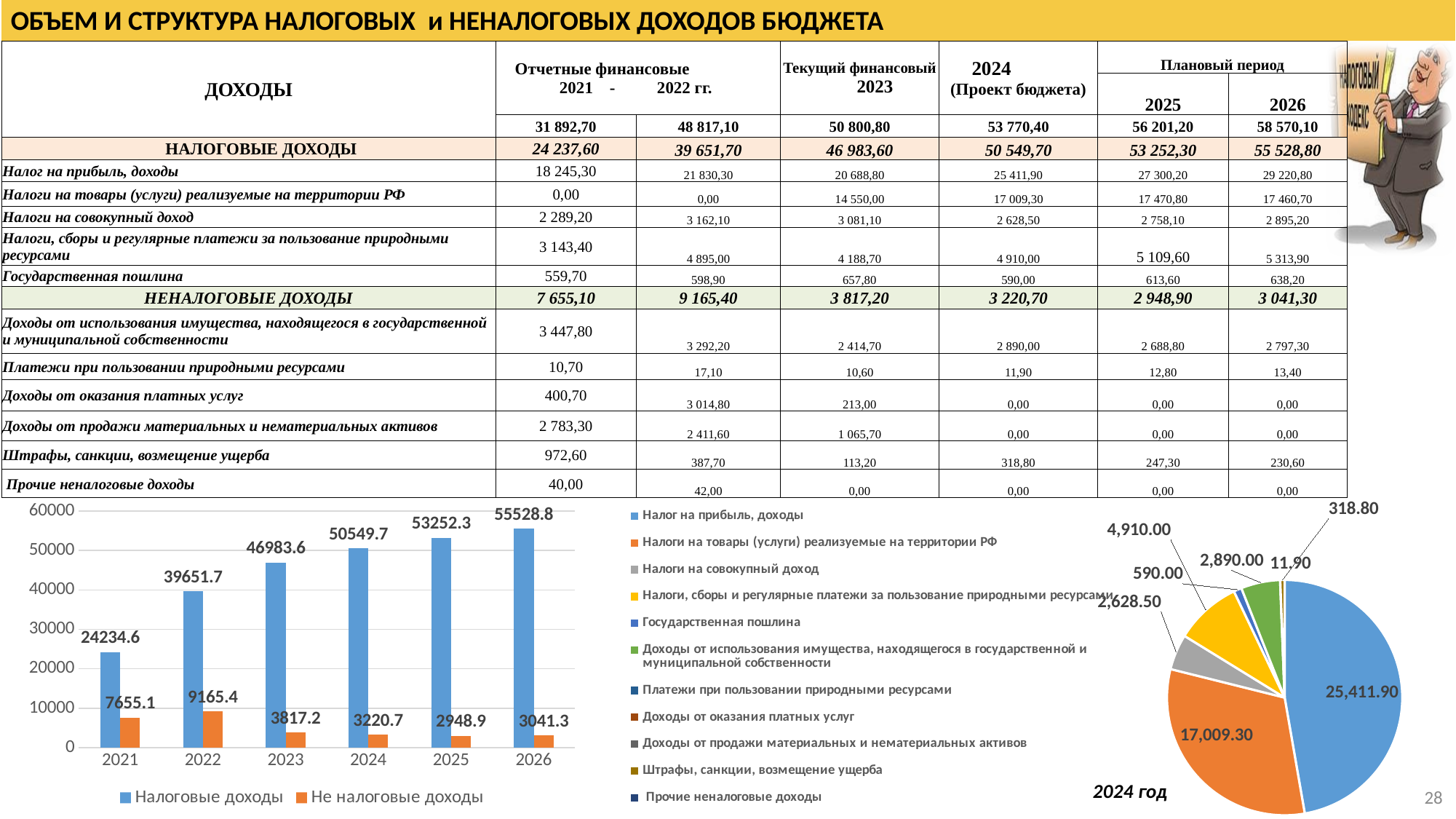
In the bar chart at the bottom left, what is the value of Не налоговые доходы for 2022? 9165.4 In the pie chart at the bottom right (2024 год), what is the value of the orange slice? 17,009.30 In the bar chart at the bottom left, which year has the lowest value of Не налоговые доходы? 2025 In the bar chart at the bottom left, what is the value of Налоговые доходы for 2024? 50549.7 In the pie chart at the bottom right (2024 год), what is the value of the largest slice? 25,411.90 In the bar chart at the bottom left, which is larger: Не налоговые доходы in 2021 or in 2023? 2021 In the bar chart at the bottom left, which year has the highest value of Налоговые доходы? 2026 In the bar chart at the bottom left, do the values of Налоговые доходы rise or fall from 2021 to 2026? Rise In the bar chart at the bottom left, how many years are shown on the x axis? 6 In the bar chart at the bottom left, what is the difference between Налоговые доходы in 2026 and in 2025? 2276.5 What kind of chart is shown at the bottom left of the slide? Bar chart In the bar chart at the bottom left, how many series does the legend list? 2